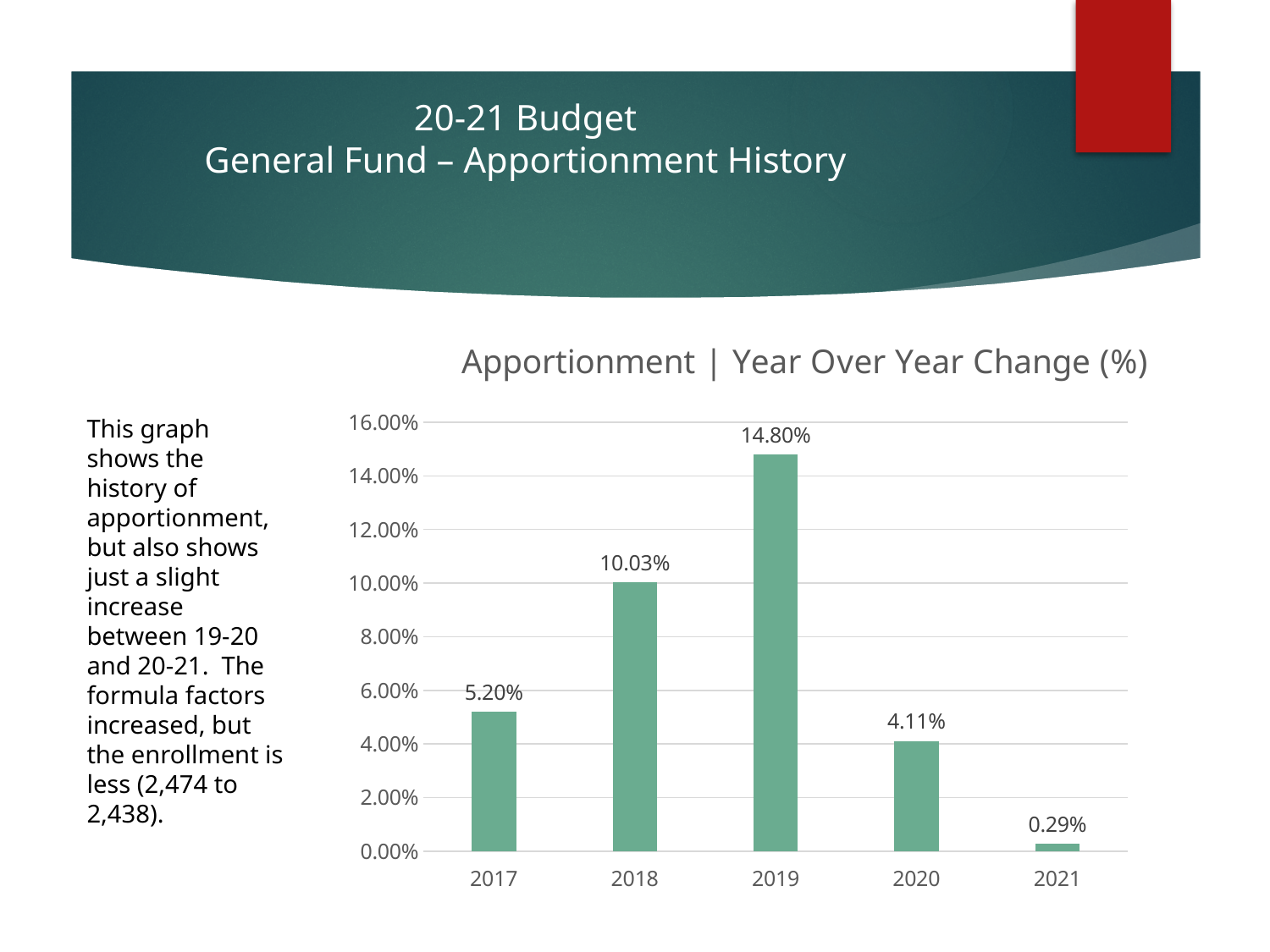
Is the value for 2018 greater or less than 8.00%? greater What is the year-over-year change for 2019? 14.80% What is the title of the chart? Apportionment | Year Over Year Change (%) Which is larger, the value for 2018 or the value for 2020? 2018 What is the difference between the 2019 and 2018 values? 4.77% What is the difference between the 2020 and 2021 values? 3.82% What is the year-over-year change for 2017? 5.20% What kind of chart is shown on the slide? Bar chart Which year has the lowest year-over-year change? 2021 Which year has the highest year-over-year change? 2019 How many years are shown on the chart? 5 What is the year-over-year change for 2021? 0.29%